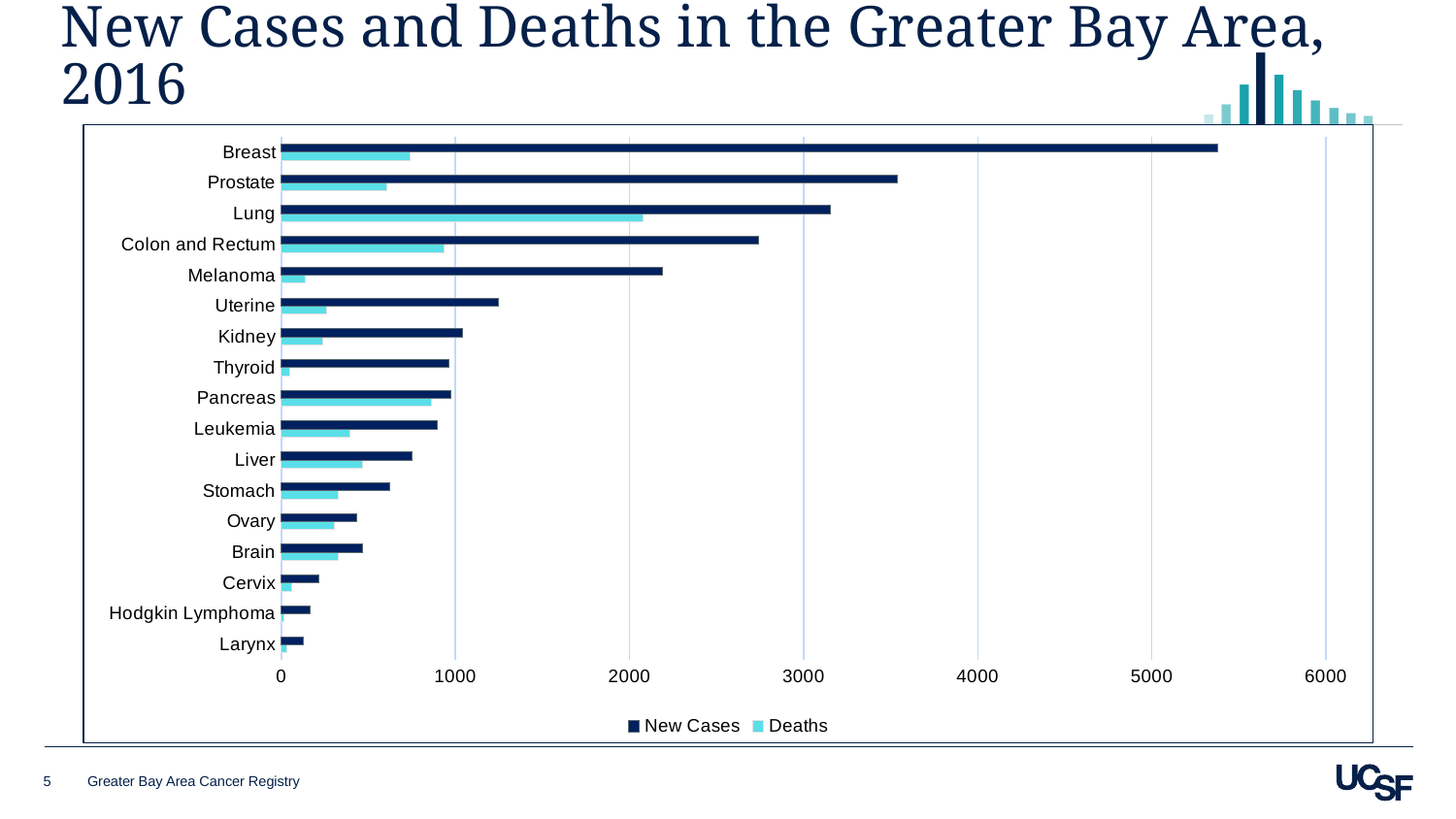
Is the value for New Cases for Colon and Rectum greater or less than 3000? less Is the value for New Cases for Prostate greater or less than 3000? greater Which cancer site has the highest number of deaths? Lung How many cancer sites (categories) are listed on the chart? 17 Which cancer site has the highest number of new cases? Breast What kind of chart is shown on the slide? bar chart Is the value for New Cases for Breast greater or less than 5000? greater Which is larger: New Cases for Prostate or New Cases for Lung? Prostate What is the title of the chart? New Cases and Deaths in the Greater Bay Area, 2016 How many series does the legend list? 2 Which cancer site has the lowest number of new cases? Larynx